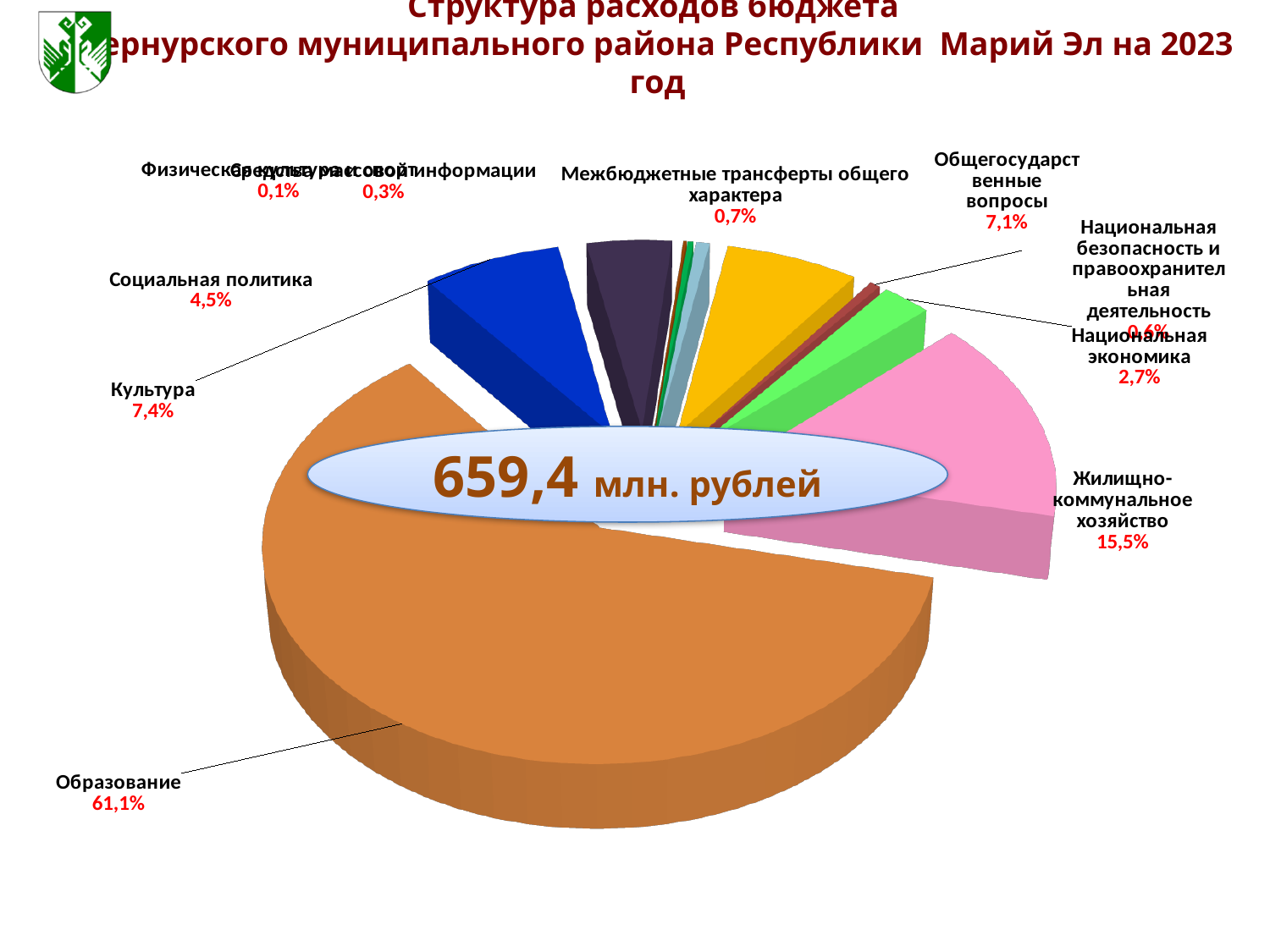
By how many percentage points does Образование exceed Жилищно-коммунальное хозяйство? 45,6% What total amount is shown in the centre of the pie chart? 659,4 млн. рублей Which has the larger share, Культура or Общегосударственные вопросы? Культура What share is labelled for Общегосударственные вопросы? 7,1% What share of expenditure does Образование account for? 61,1% What is the difference between the shares of Культура and Социальная политика? 2,9% Which category has the largest share of the pie? Образование What percentage is shown for Культура? 7,4% What percentage is shown for Социальная политика? 4,5% What percentage is shown for Жилищно-коммунальное хозяйство? 15,5% What kind of chart is shown on the slide? pie chart What percentage is shown for Национальная экономика? 2,7%